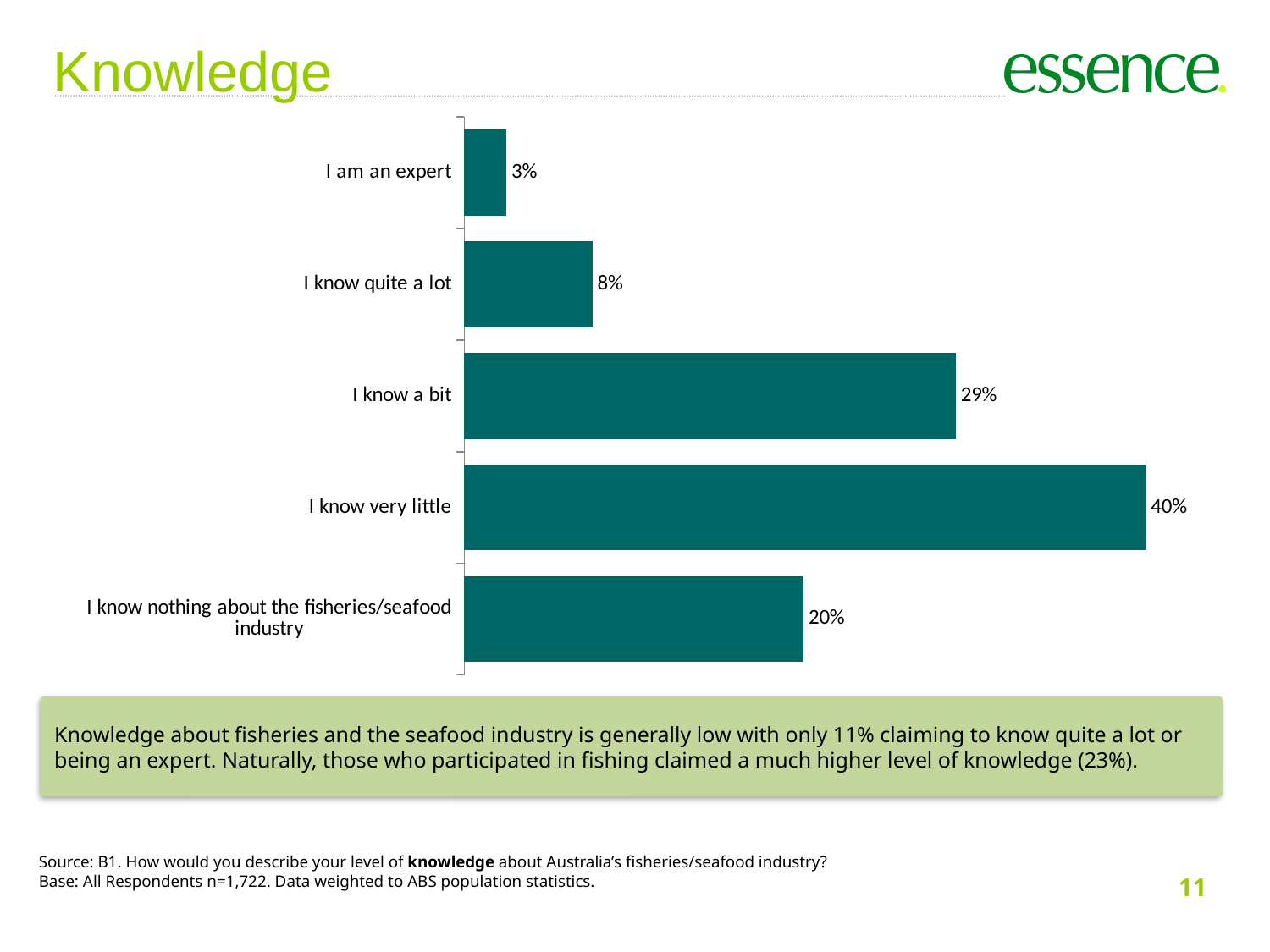
How many categories are shown in the chart? 5 What percentage of respondents said "I know nothing about the fisheries/seafood industry"? 20% What type of chart is shown on the slide? Bar chart What percentage of respondents said "I know very little"? 40% Which is larger: the percentage for "I know a bit" or for "I know nothing about the fisheries/seafood industry"? I know a bit Which category has the highest percentage? I know very little What is the difference in percentage points between "I know very little" and "I know a bit"? 11 What percentage of respondents said "I am an expert"? 3% What percentage of respondents said "I know quite a lot"? 8% What percentage of respondents said "I know a bit"? 29% What is the combined percentage of "I am an expert" and "I know quite a lot"? 11% Which category has the lowest percentage? I am an expert